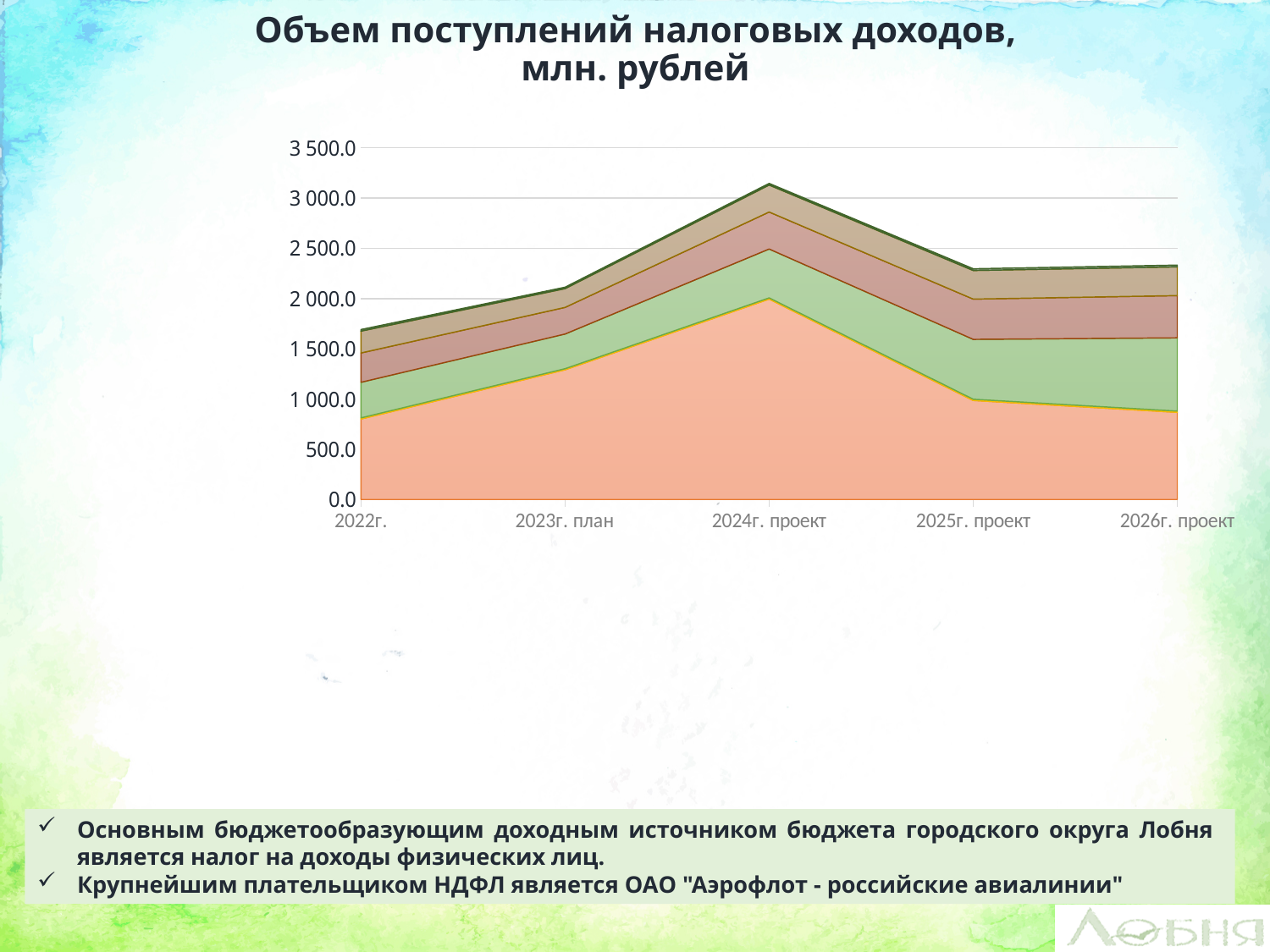
Does the total value rise or fall from 2022г. to 2024г. проект? Rise What kind of chart is shown on the slide? Area chart What is the title of the chart? Объем поступлений налоговых доходов, млн. рублей Which has the larger total value, 2022г. or 2026г. проект? 2026г. проект Is the value of the bottom (orange) band for 2022г. greater or less than 1 000.0? less Is the total value for 2026г. проект greater or less than 2 500.0? less Is the total value for 2024г. проект greater or less than 3 000.0? greater Does the total value rise or fall from 2024г. проект to 2025г. проект? Fall How many categories are shown along the x axis of the chart? 5 Which category has the lowest total value in the chart? 2022г. Which category has the highest total value in the chart? 2024г. проект